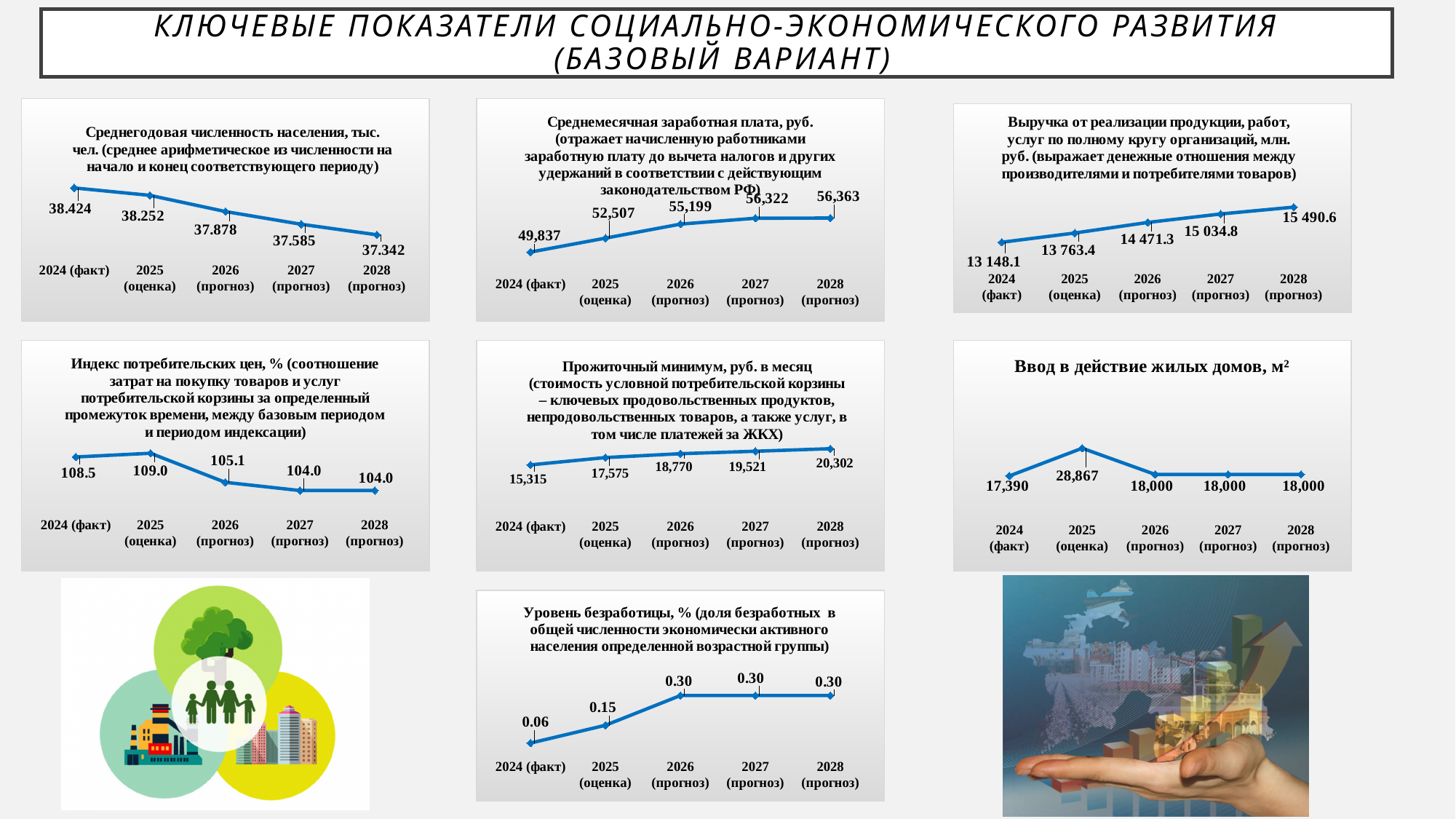
In the chart 'Среднемесячная заработная плата' (top-middle), what is the value for 2026 (прогноз)? 55,199 In the chart 'Среднегодовая численность населения' (top-left), what is the value for 2024 (факт)? 38.424 In the chart 'Ввод в действие жилых домов' (middle-right), which year has the highest value? 2025 (оценка) In the chart 'Прожиточный минимум' (middle-middle), what is the value for 2025 (оценка)? 17,575 In the chart 'Выручка от реализации продукции' (top-right), what is the value for 2028 (прогноз)? 15 490.6 In the chart 'Выручка от реализации продукции' (top-right), how many data points are plotted? 5 In the chart 'Индекс потребительских цен' (middle-left), what is the difference between the 2024 (факт) value and the 2028 (прогноз) value? 4.5 What type of chart is used for 'Уровень безработицы' (bottom-middle)? line chart In the chart 'Индекс потребительских цен' (middle-left), which year has the highest value? 2025 (оценка) In the chart 'Среднемесячная заработная плата' (top-middle), which year has the lowest value? 2024 (факт) In the chart 'Среднегодовая численность населения' (top-left), do the values rise or fall from 2024 to 2028? fall In the chart 'Уровень безработицы' (bottom-middle), which is larger: the value for 2025 (оценка) or the value for 2026 (прогноз)? 2026 (прогноз)